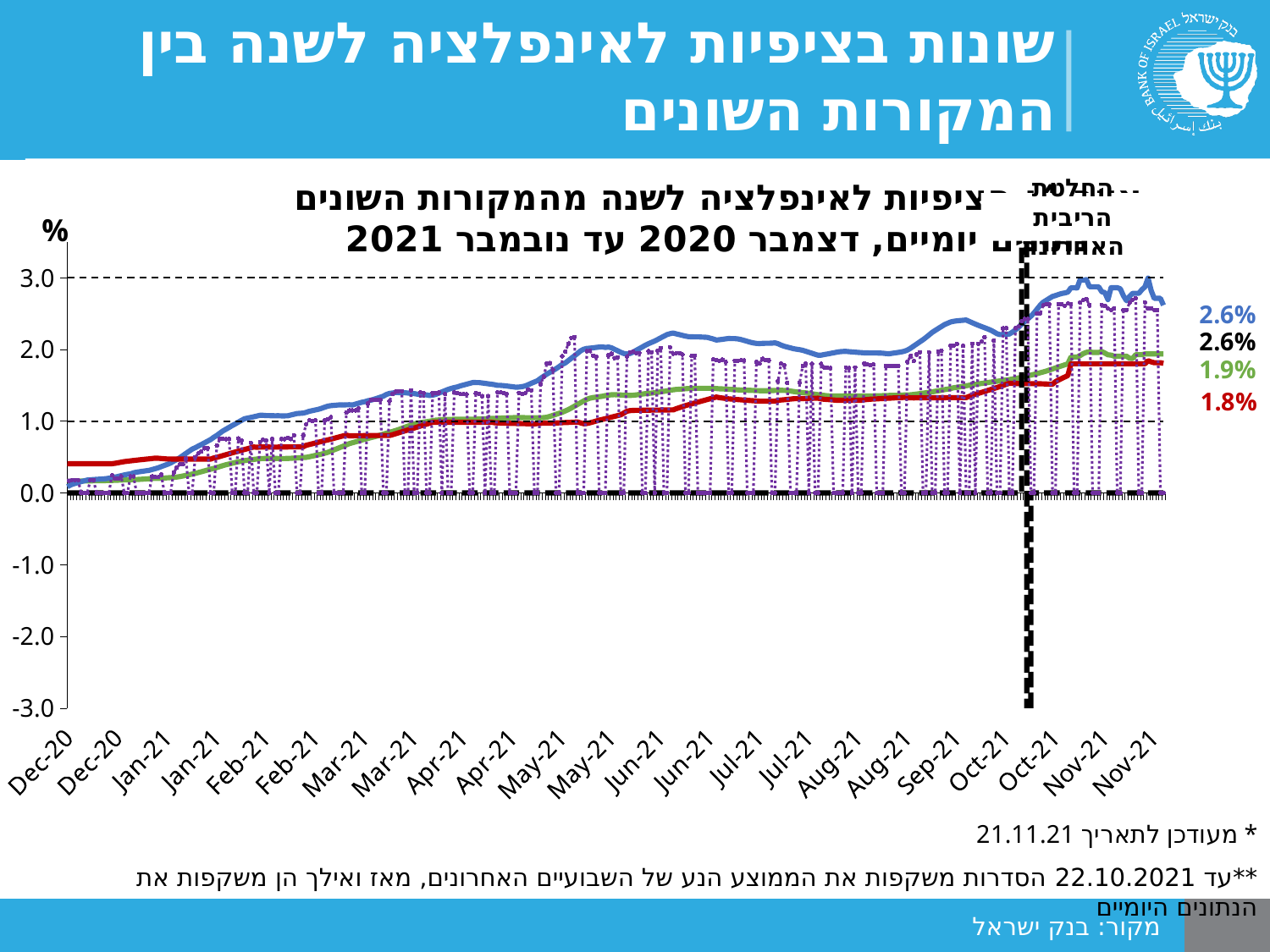
Which line has the lowest labelled end value? the red line (1.8%) What unit is shown at the top of the vertical axis? % Is the value of the red line at Jun-21 greater or less than 2.0? less What is the value labelled at the end of the green line? 1.9% Which is larger, the end value of the green line or the end value of the red line? the green line (1.9%) Does the blue line generally rise or fall from Dec-20 to Nov-21? rise What is the value labelled at the end of the red line? 1.8% What is the highest value shown on the vertical axis? 3.0 What is the value labelled at the end of the blue line? 2.6% Is the value of the red line at Dec-20 greater or less than 1.0? less What kind of chart is shown on the slide? line chart What is the difference between the end value of the blue line (2.6%) and the end value of the red line (1.8%)? 0.8%